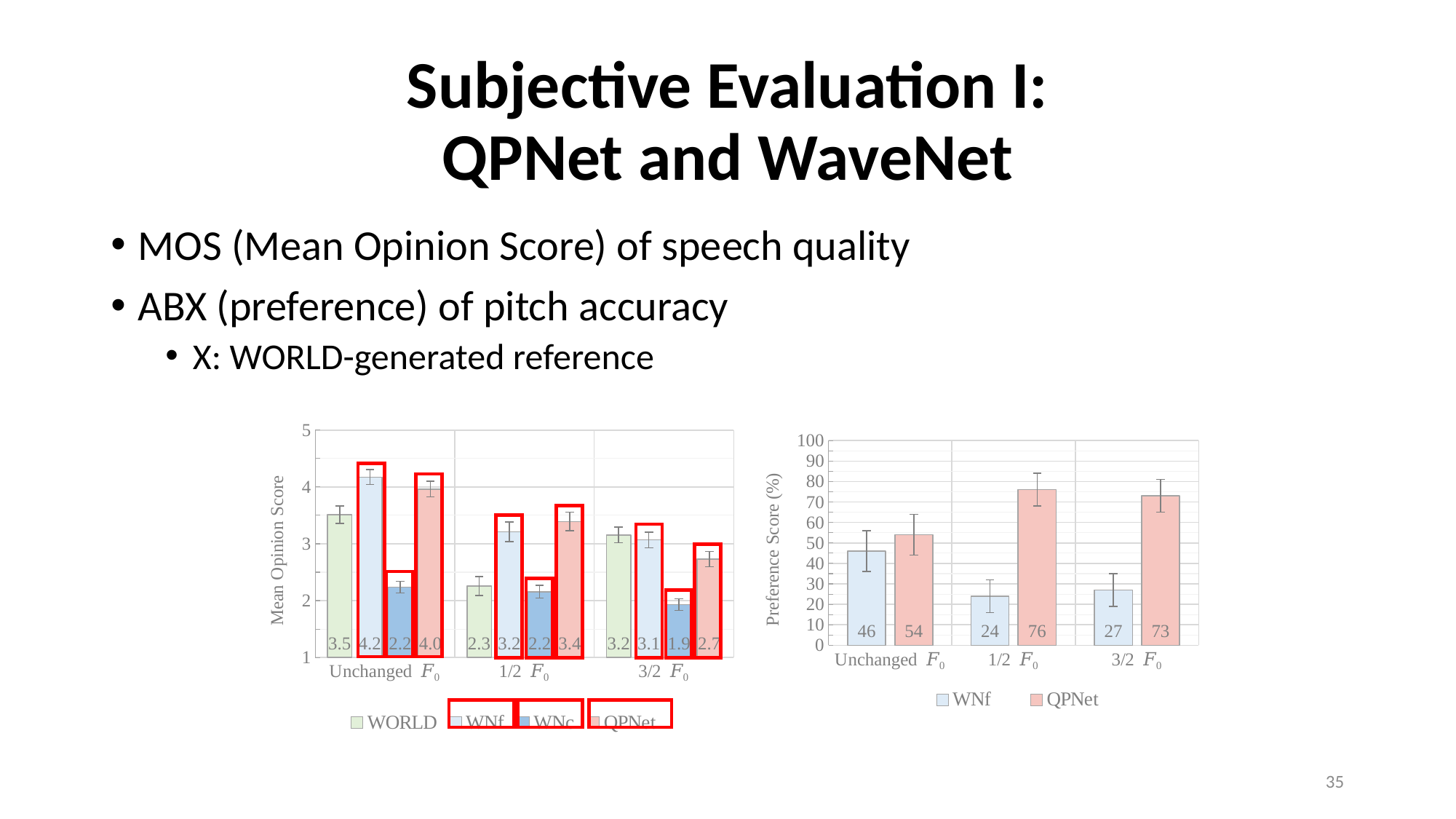
In the left chart (Mean Opinion Score), which series has the highest value at Unchanged F0? WNf In the left chart (Mean Opinion Score), what is the value for WNf at Unchanged F0? 4.2 In the left chart (Mean Opinion Score), what is the difference between the WORLD and WNc values at Unchanged F0? 1.3 In the right chart (Preference Score), which is larger at Unchanged F0, WNf or QPNet? QPNet In the right chart (Preference Score), what is the difference between QPNet and WNf at 3/2 F0? 46 In the left chart (Mean Opinion Score), how many series does the legend list? 4 In the right chart (Preference Score), what is the value for QPNet at 1/2 F0? 76 What kind of chart is the right chart (Preference Score)? Bar chart In the right chart (Preference Score), what is the value for WNf at 3/2 F0? 27 In the left chart (Mean Opinion Score), which series has the lowest value at 3/2 F0? WNc In the left chart (Mean Opinion Score), what is the value for QPNet at 1/2 F0? 3.4 In the right chart (Preference Score), how many categories are shown on the x axis? 3